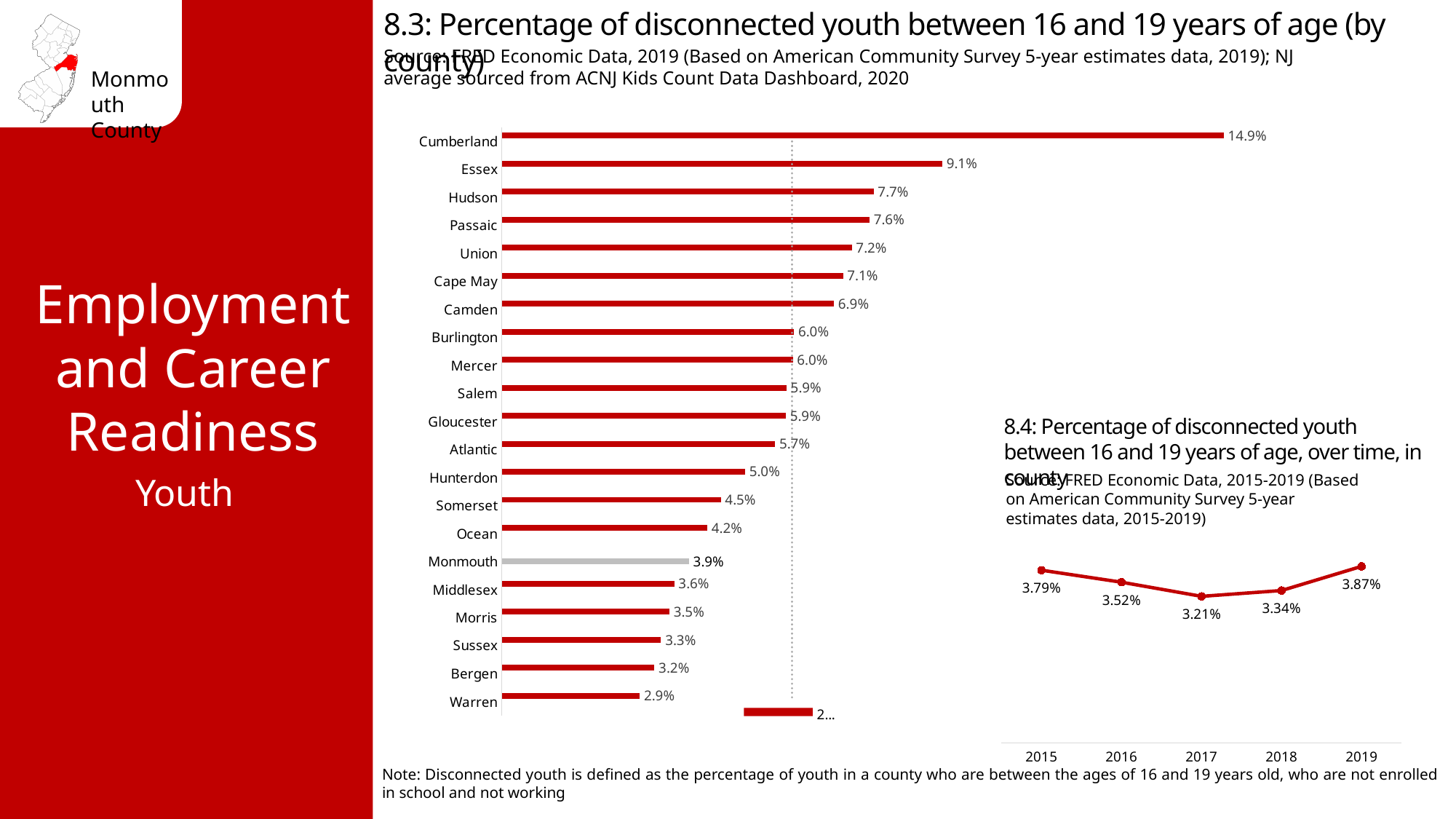
In chart 8.3 (percentage of disconnected youth by county), how many counties are plotted? 21 In chart 8.4 (percentage of disconnected youth over time), which year has the highest value? 2019 In chart 8.4 (percentage of disconnected youth over time), what is the value for 2017? 3.21% In chart 8.3 (percentage of disconnected youth by county), what is the value for Monmouth? 3.9% In chart 8.3 (percentage of disconnected youth by county), what is the value for Cumberland? 14.9% In chart 8.4 (percentage of disconnected youth over time), what is the difference between the 2019 and 2015 values? 0.08% What kind of chart is chart 8.3 (percentage of disconnected youth by county)? Bar chart In chart 8.3 (percentage of disconnected youth by county), which county has the lowest value? Warren In chart 8.3 (percentage of disconnected youth by county), which is larger, Ocean or Somerset? Somerset In chart 8.3 (percentage of disconnected youth by county), what is the difference between Essex and Hudson? 1.4% In chart 8.4 (percentage of disconnected youth over time), how many data points are plotted? 5 In chart 8.3 (percentage of disconnected youth by county), which county has the highest value? Cumberland